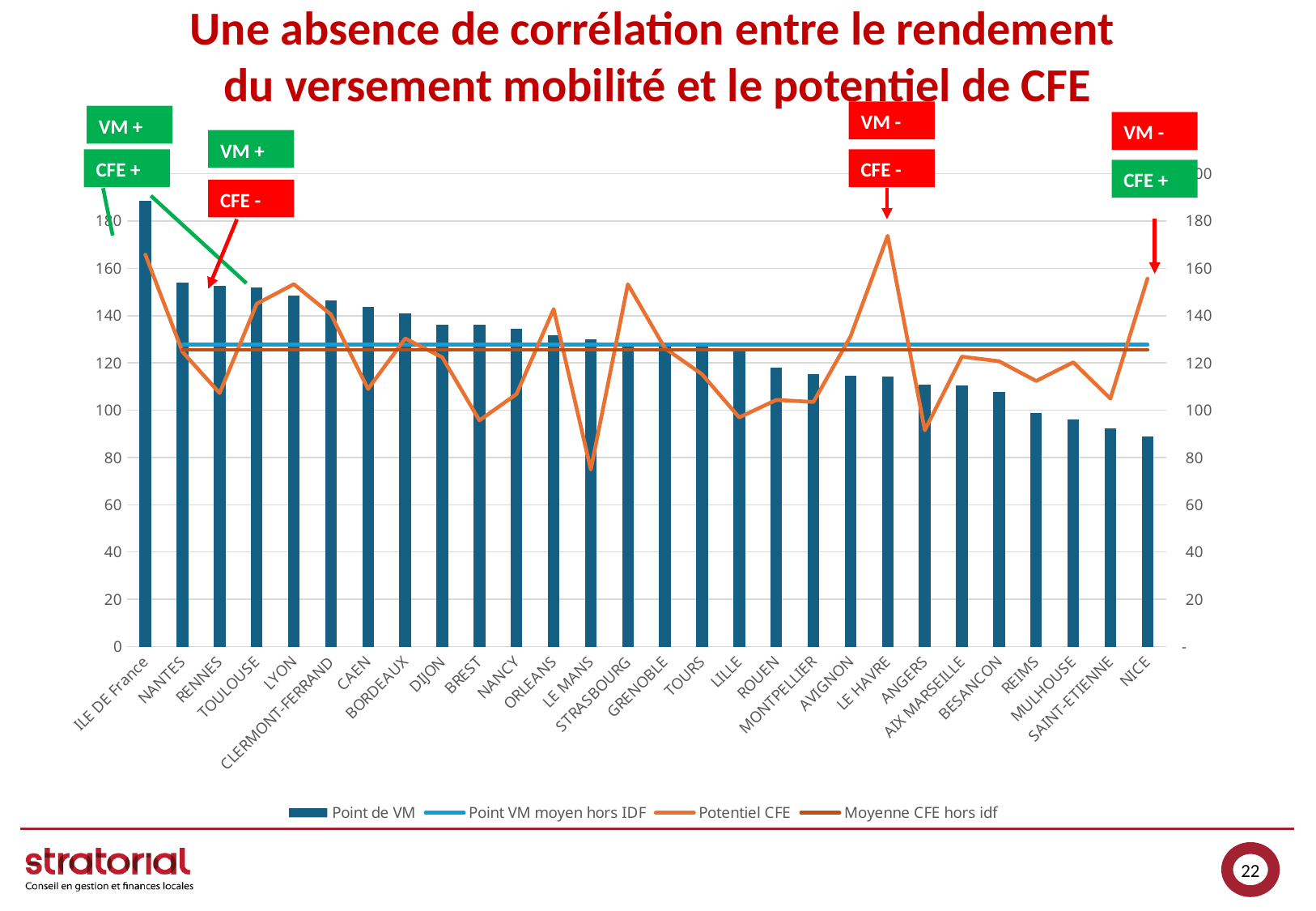
Which city has the larger Point de VM bar, NANTES or NICE? NANTES Which city has the lowest Point de VM bar? NICE Which city has the lowest value on the Potentiel CFE line? LE MANS Which city has the highest value on the Potentiel CFE line? LE HAVRE Is the Potentiel CFE value for LE MANS greater or less than 80? less How many cities are shown along the x axis of the chart? 28 Is the Point de VM value for ILE DE France greater or less than 180? greater Which city has the highest Point de VM bar? ILE DE France What kind of chart is shown on the slide? A combined bar and line chart Which series in the legend is drawn in orange? Potentiel CFE Do the Point de VM bars rise or fall from left to right along the x axis? Fall How many series does the chart legend list? 4